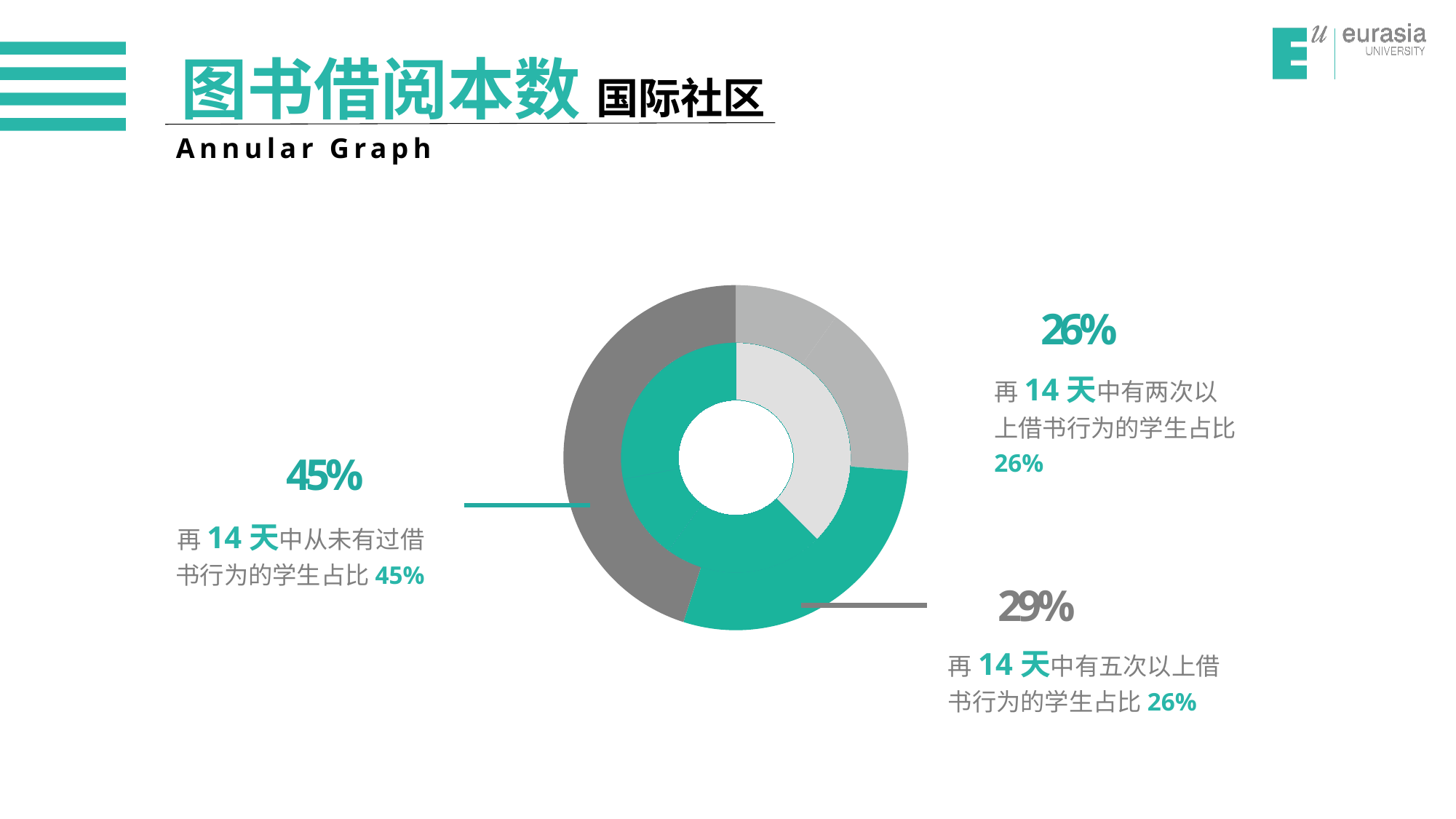
Which segment of the donut chart is the largest? 45% (从未有过借书行为的学生) What percentage is shown for students who never borrowed a book in 14 days (再14天中从未有过借书行为的学生占比)? 45% What kind of chart is shown on the slide? Pie (donut) chart Which is larger: the share of students who never borrowed (45%) or the share who borrowed five or more times (29%)? Students who never borrowed (45%) What large percentage label is shown next to the description of students who borrowed two or more times in 14 days (有两次以上借书行为)? 26% Which segment of the donut chart is the smallest? 26% (有两次以上借书行为的学生) What is the main title of the slide? 图书借阅本数 国际社区 What large percentage label is shown next to the description of students who borrowed five or more times in 14 days (有五次以上借书行为)? 29% What is the difference between the 29% segment and the 26% segment? 3% What is the difference between the 45% segment and the 29% segment? 16% What is the English subtitle printed under the slide title? Annular Graph